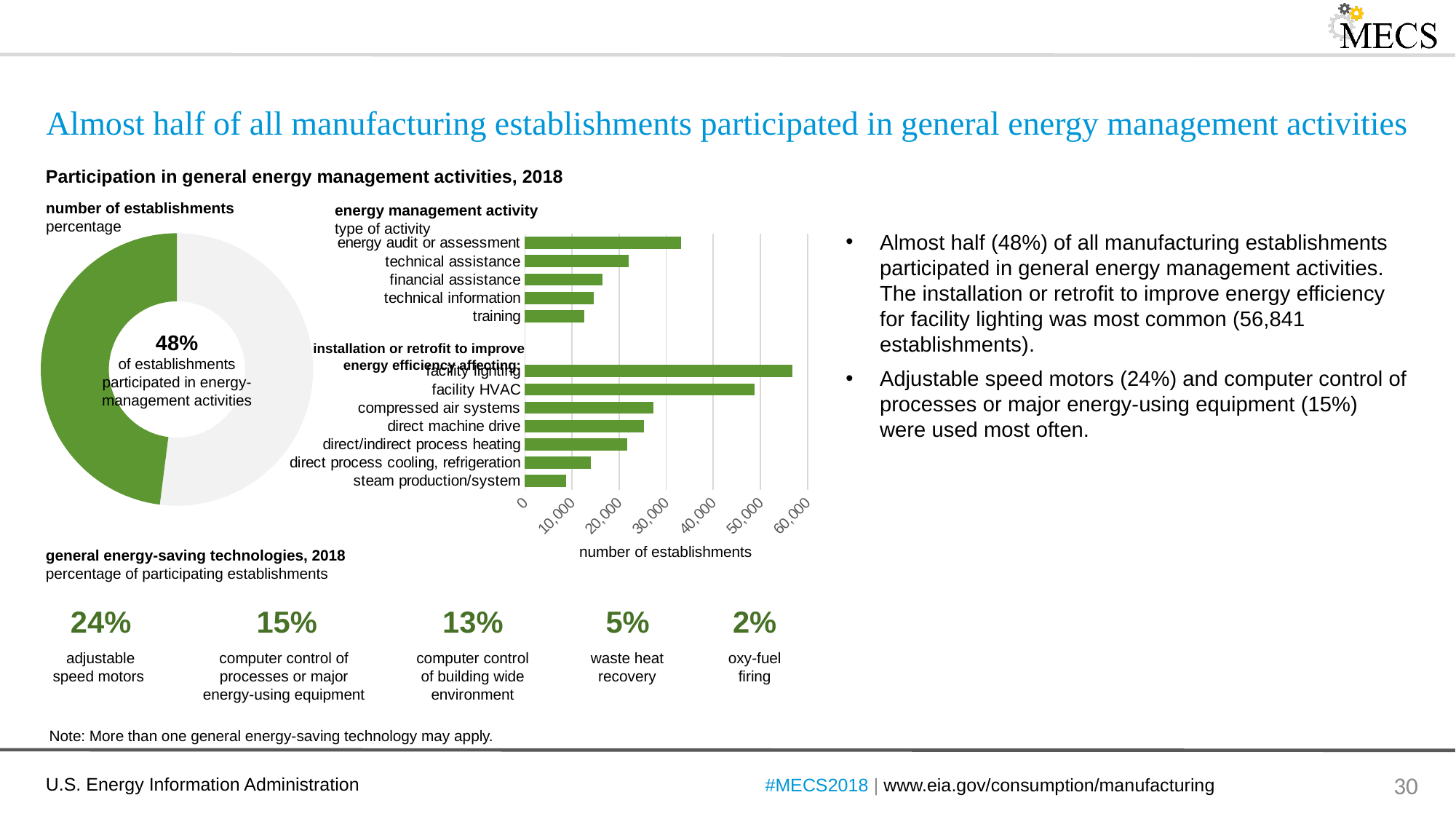
What kind of chart is the chart titled 'energy management activity'? bar chart What is the label on the horizontal axis of the 'energy management activity' bar chart? number of establishments In the 'energy management activity' bar chart, which category has the highest number of establishments? facility lighting In the 'energy management activity' bar chart, is the value for steam production/system greater or less than 10,000? less In the 'energy management activity' bar chart, how many categories are plotted in total? 12 In the 'energy management activity' bar chart, which is larger: facility HVAC or direct machine drive? facility HVAC In the 'energy management activity' bar chart, is the value for compressed air systems greater or less than 30,000? less In the 'energy management activity' bar chart, is the value for facility lighting greater or less than 50,000? greater In the donut chart on the left, what percentage of establishments participated in energy-management activities? 48% In the 'energy management activity' bar chart, which is larger: energy audit or assessment, or technical assistance? energy audit or assessment In the 'energy management activity' bar chart, which category has the lowest number of establishments? steam production/system